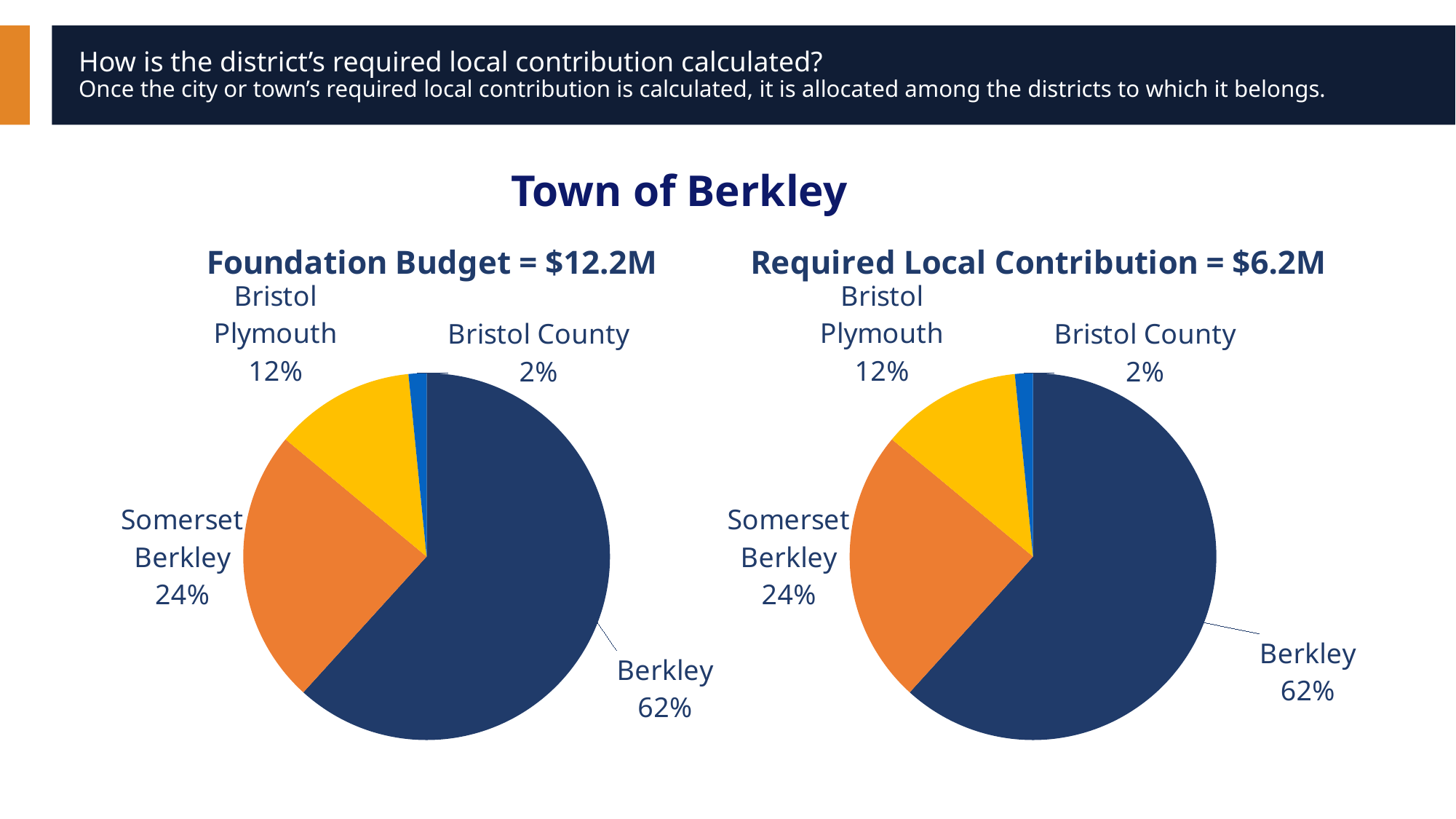
In the Foundation Budget = $12.2M chart, what share does Berkley have? 62% In the Required Local Contribution = $6.2M chart, which district has the smallest slice? Bristol County In the Foundation Budget = $12.2M chart, what share does Bristol Plymouth have? 12% In the Required Local Contribution = $6.2M chart, what share does Somerset Berkley have? 24% What is the title of the chart on the left of the slide? Foundation Budget = $12.2M In the Required Local Contribution = $6.2M chart, what colour is the Bristol Plymouth slice? Yellow In the Foundation Budget = $12.2M chart, what is the difference between the Somerset Berkley and Bristol Plymouth shares? 12% In the Required Local Contribution = $6.2M chart, which is larger, Somerset Berkley or Bristol Plymouth? Somerset Berkley What kind of chart is the Required Local Contribution = $6.2M chart? Pie chart In the Required Local Contribution = $6.2M chart, what share does Bristol County have? 2% How many slices does the Foundation Budget = $12.2M chart have? 4 In the Foundation Budget = $12.2M chart, which district has the largest slice? Berkley